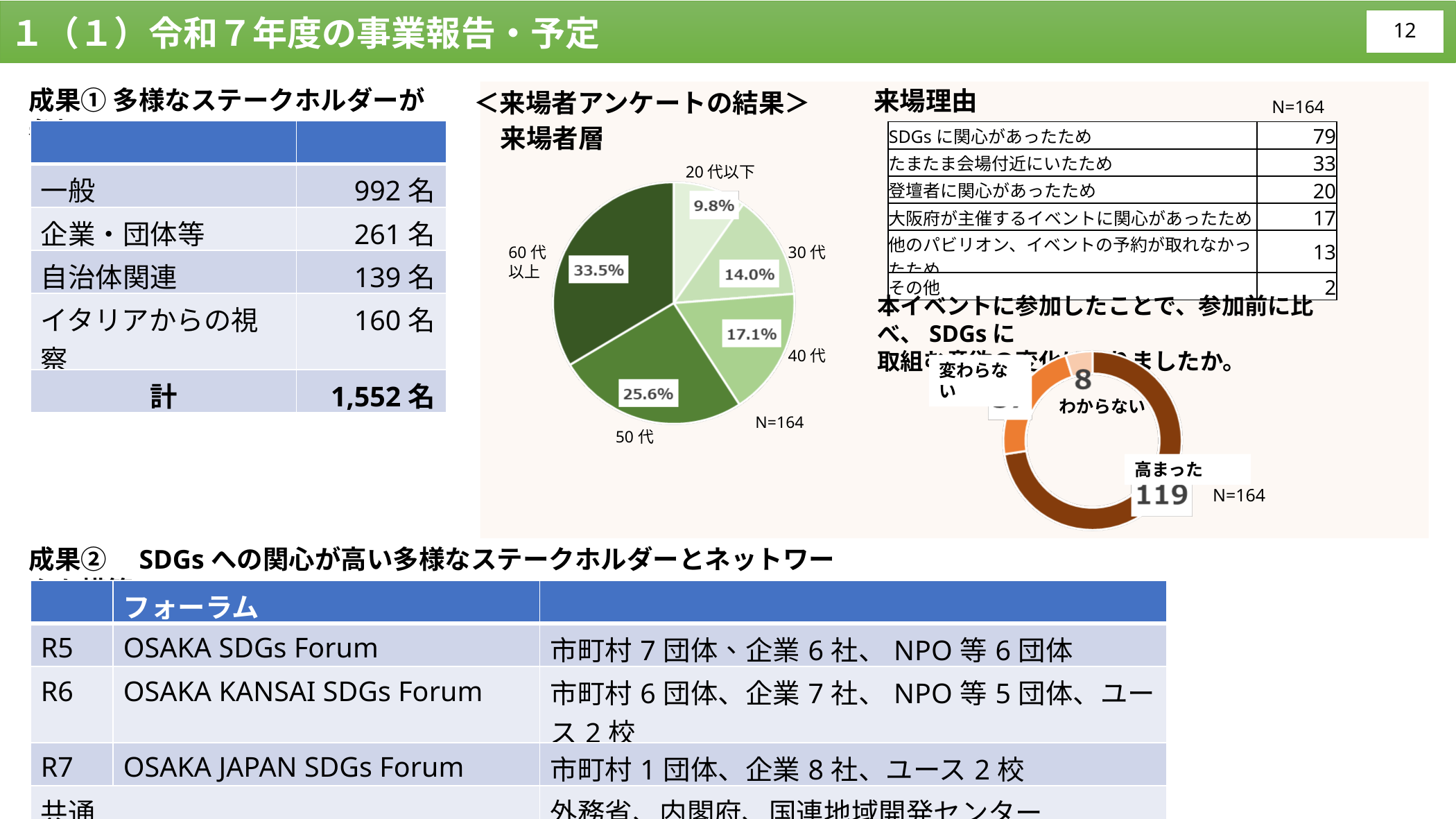
How many age-group slices does the 来場者層 pie chart have? 5 In the 来場者層 pie chart, what percentage is shown for 40代? 17.1% In the donut chart about change in SDGs attitude, how many respondents answered わからない? 8 In the 来場者層 pie chart, what percentage is shown for 20代以下? 9.8% In the donut chart about change in SDGs attitude, which response has the largest count? 高まった In the donut chart about change in SDGs attitude, how many respondents answered 高まった? 119 What kind of chart is the 来場者層 chart? pie chart In the 来場者層 pie chart, what percentage is shown for 60代以上? 33.5% In the 来場者層 pie chart, what is the difference in percentage points between 50代 and 30代? 11.6 In the 来場者層 pie chart, which age group has the largest share? 60代以上 In the 来場者層 pie chart, which is larger, the share for 40代 or the share for 30代? 40代 In the 来場者層 pie chart, which age group has the smallest share? 20代以下